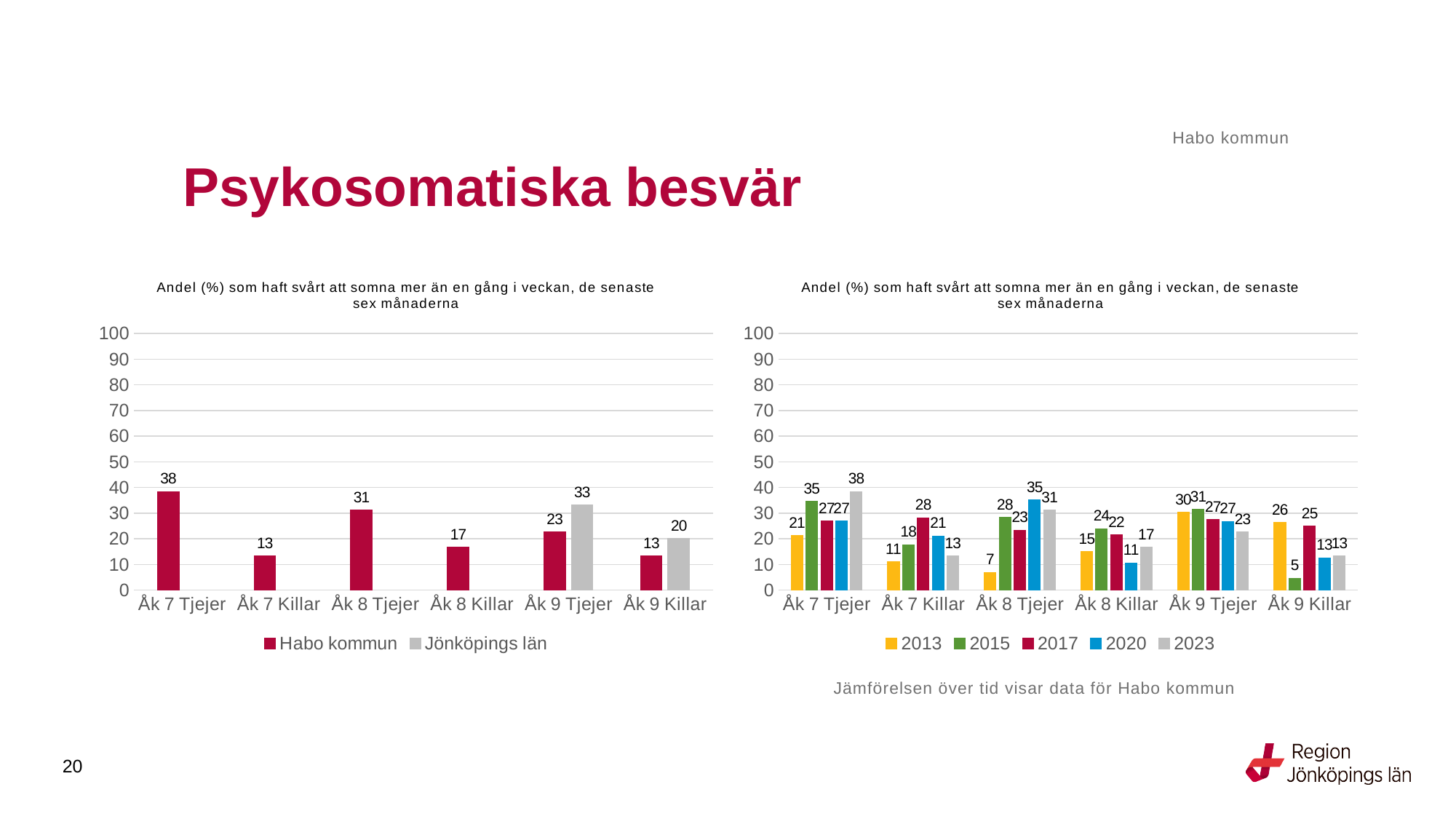
In the right chart, how many series does the legend list? 5 In the left chart, which category has the highest value for Habo kommun? Åk 7 Tjejer In the left chart, what is the value for Habo kommun for Åk 7 Tjejer? 38 In the right chart, how many categories are shown on the x axis? 6 In the left chart, what is the value for Jönköpings län for Åk 9 Tjejer? 33 In the right chart, which is larger for Åk 8 Killar: 2015 or 2020? 2015 In the left chart, what is the difference between Jönköpings län and Habo kommun for Åk 9 Killar? 7 In the right chart, which year has the lowest value for Åk 9 Killar? 2015 In the right chart, what is the value for 2015 for Åk 8 Tjejer? 28 What kind of chart is the left chart? Bar chart In the left chart, how many series does the legend list? 2 In the right chart, what is the value for 2013 for Åk 9 Tjejer? 30